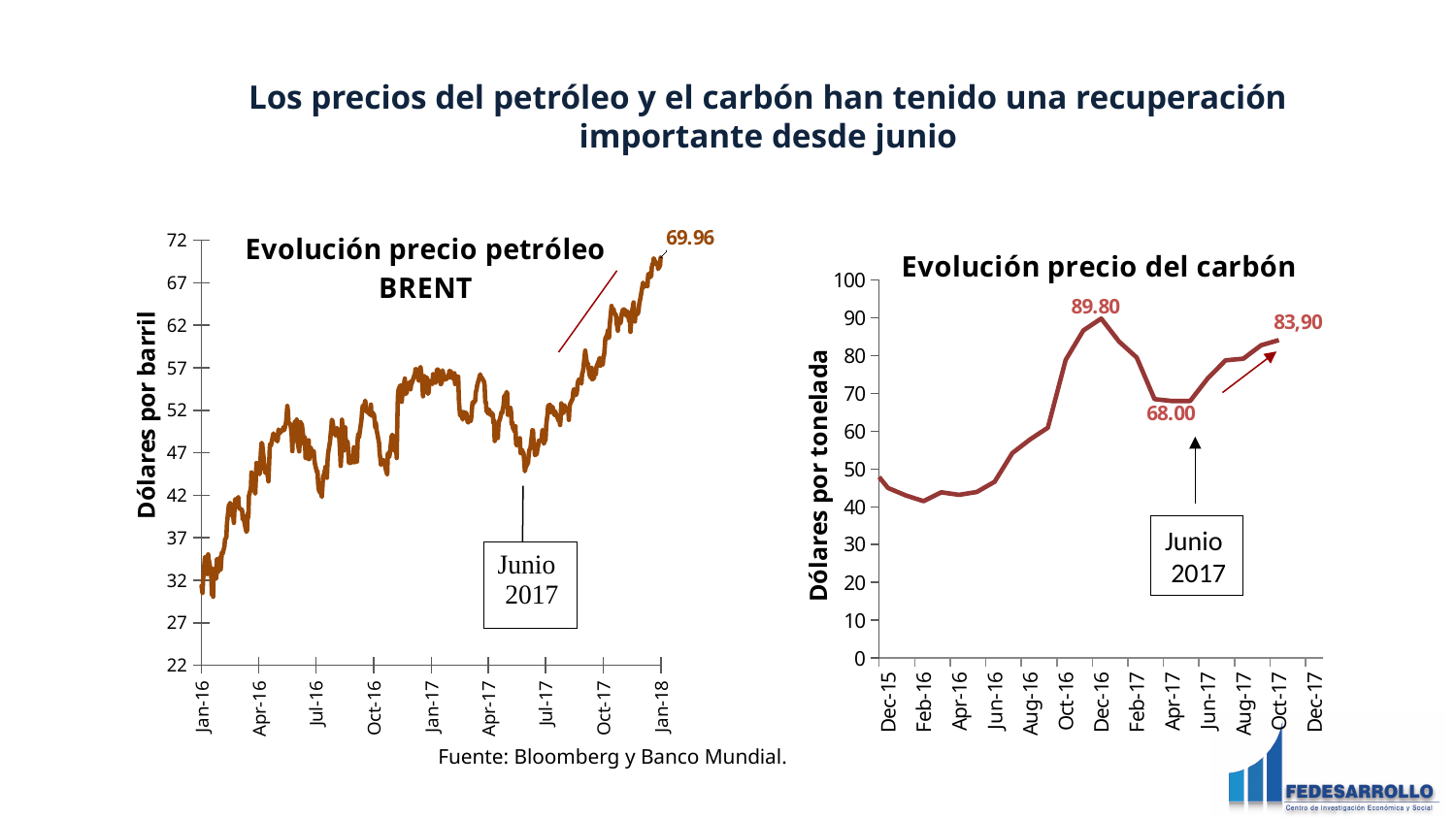
What is the y-axis label of the 'Evolución precio petróleo BRENT' chart? Dólares por barril On the 'Evolución precio del carbón' chart, what value is labeled at the peak around Dec-16? 89.80 On the 'Evolución precio del carbón' chart, what is the last labeled value at the end of the series? 83,90 On the 'Evolución precio petróleo BRENT' chart, is the value in Jan-16 greater or less than 37? less What kind of chart is the 'Evolución precio petróleo BRENT' chart? line chart On the 'Evolución precio petróleo BRENT' chart, what value is labeled at the end of the series in Jan-18? 69.96 On the 'Evolución precio del carbón' chart, which is larger: the value labeled at Dec-16 or the value labeled at the end of the series? Dec-16 (89.80) On the 'Evolución precio del carbón' chart, do values rise or fall from Junio 2017 to the end of the series? rise On the 'Evolución precio del carbón' chart, what is the difference between the peak value of 89.80 and the Junio 2017 value of 68.00? 21.80 On the 'Evolución precio del carbón' chart, at which month does the labeled peak value occur? Dec-16 On the 'Evolución precio del carbón' chart, what value is labeled at Junio 2017? 68.00 On the 'Evolución precio del carbón' chart, is the value in Feb-16 greater or less than 50? less